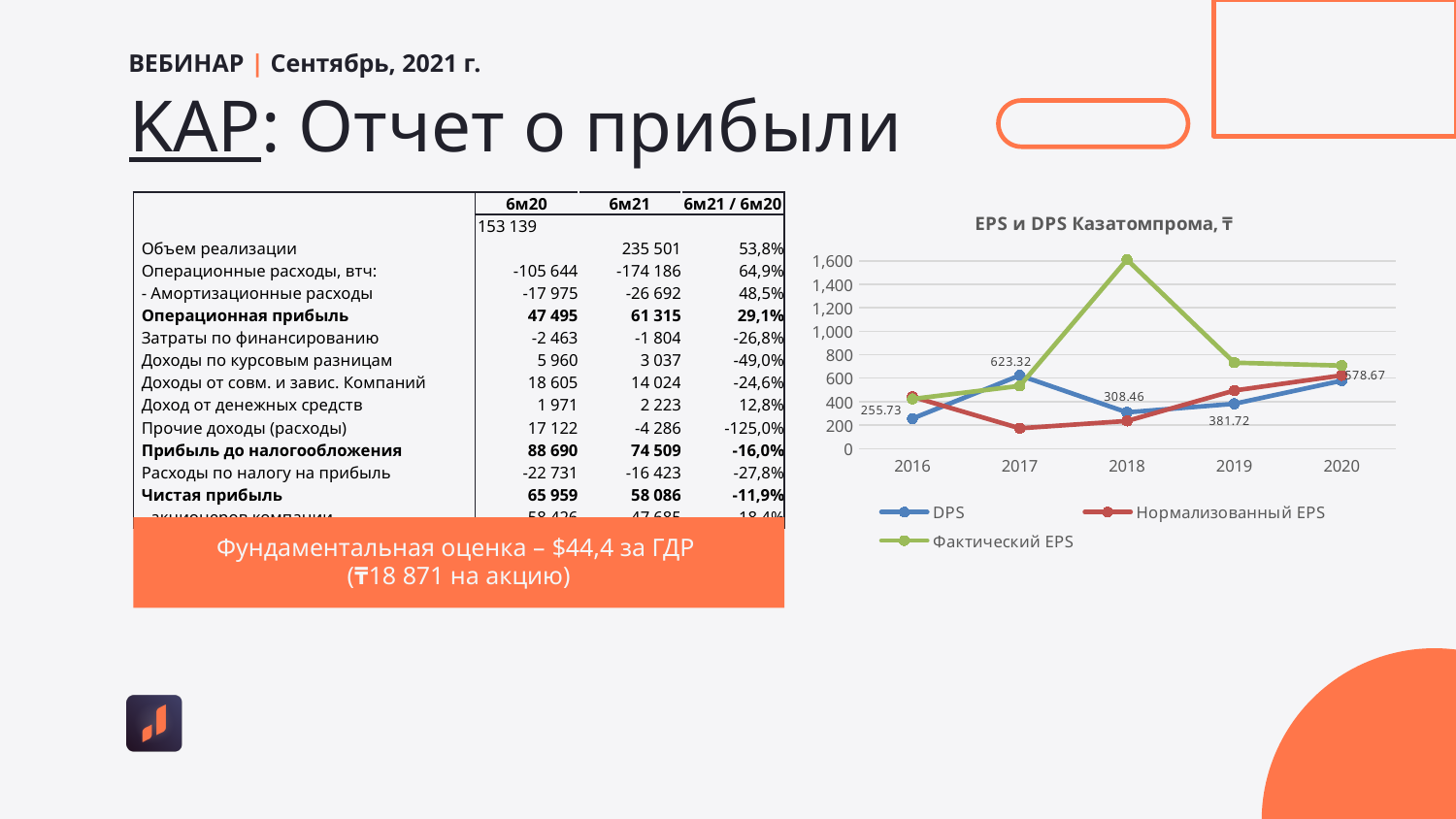
How many years are plotted along the x axis of the chart? 5 What is the DPS value for 2016? 255.73 In which year is DPS the highest? 2017 What is the DPS value for 2020? 578.67 In which year is DPS the lowest? 2016 Is the value of Фактический EPS for 2018 greater or less than 1,400? greater What is the DPS value for 2017? 623.32 Does DPS rise or fall from 2018 to 2020? rise What kind of chart is shown on the slide? line chart What is the title of the chart on the slide? EPS и DPS Казатомпрома, ₸ How many series does the chart's legend list? 3 What is the difference between the DPS values for 2017 and 2016? 367.59